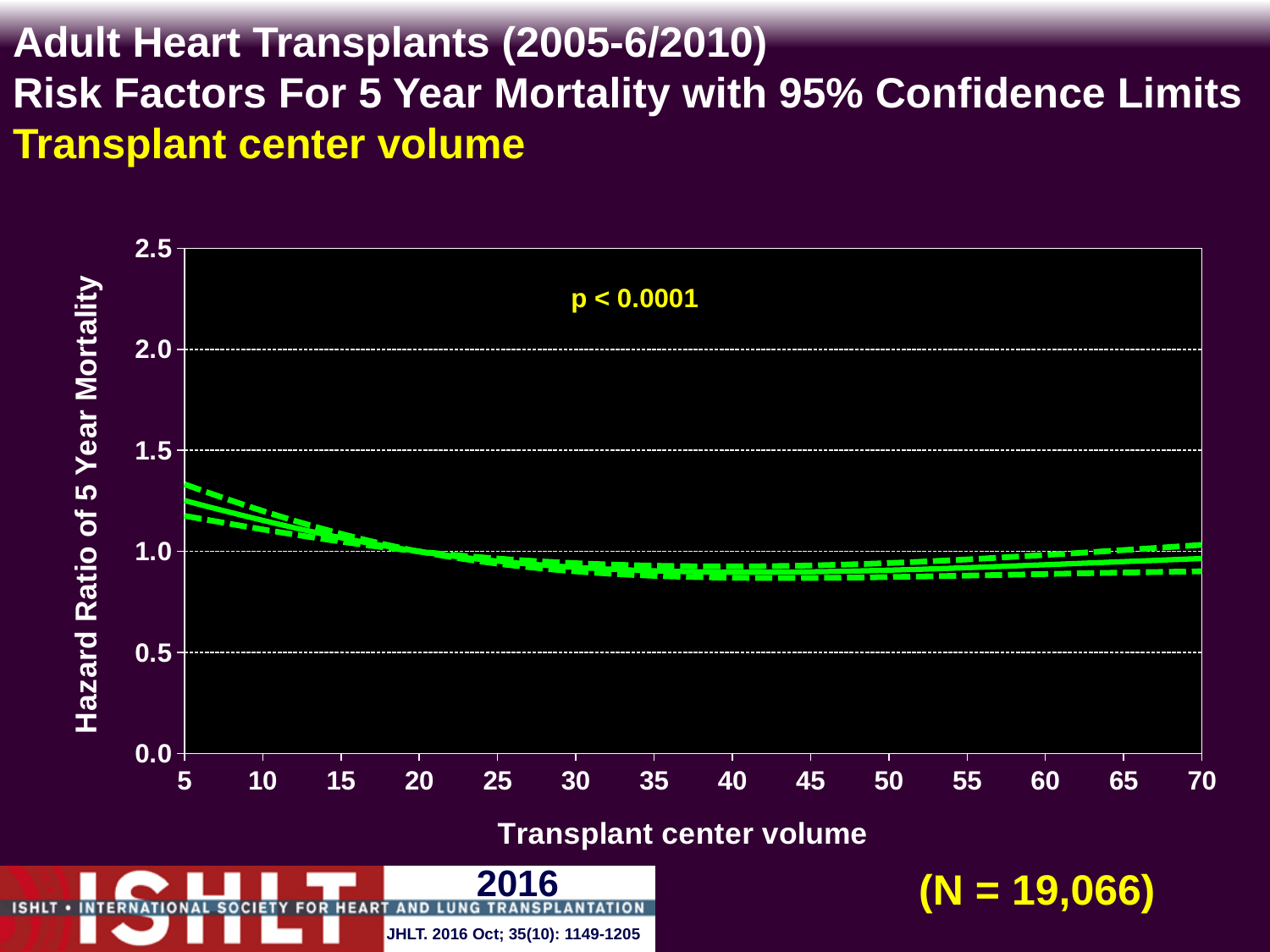
How many tick labels are shown on the y axis? 6 Is the hazard ratio at a transplant center volume of 5 greater or less than 1.5? less How many tick labels are shown on the x axis? 14 What kind of chart is shown on the slide? line chart Is the hazard ratio at a transplant center volume of 40 greater or less than 1.0? less What p-value is printed on the chart? p < 0.0001 At which labelled transplant center volume on the x axis is the hazard ratio highest? 5 What is the sample size N shown on the slide? N = 19,066 Is the hazard ratio at a transplant center volume of 5 greater or less than 1.0? greater Which has the larger hazard ratio: a transplant center volume of 5 or of 40? 5 Does the hazard ratio rise or fall as transplant center volume increases from 5 to 40? fall